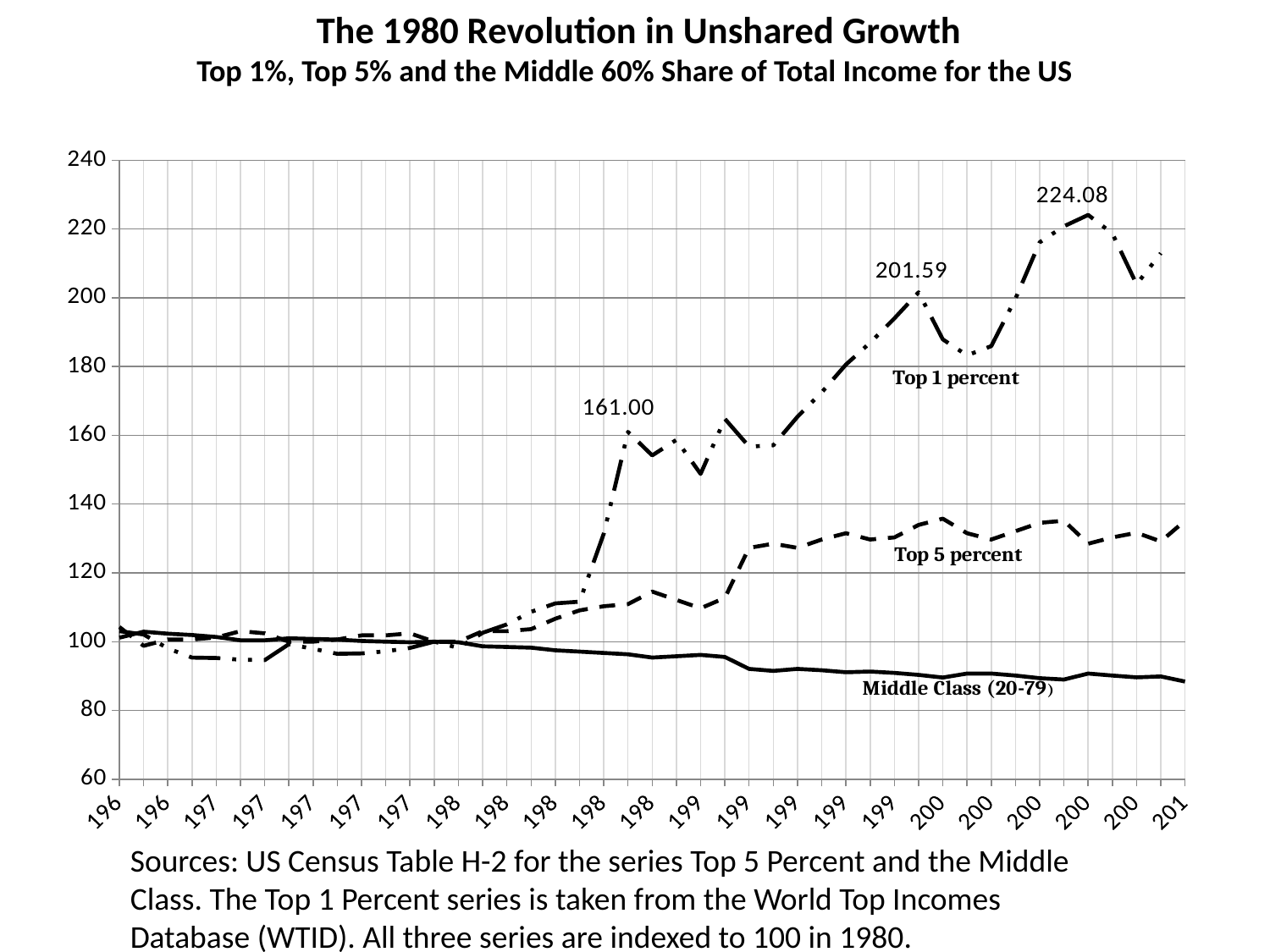
What is the difference between the labeled values 224.08 and 201.59 on the Top 1 percent line? 22.49 What kind of chart is shown on the slide? Line chart What is the highest data label shown on the Top 1 percent line? 224.08 How many data series are plotted on the chart? 3 What is the middle data label printed on the Top 1 percent line, between 161.00 and 224.08? 201.59 Does the Middle Class (20-79) series generally rise or fall from left to right across the chart? Fall What is the difference between the labeled values 224.08 and 161.00 on the Top 1 percent line? 63.08 At the right end of the chart, which series is higher: Top 1 percent or Top 5 percent? Top 1 percent At the right end of the chart, is the value for the Middle Class (20-79) series greater or less than 100? less What is the first (leftmost) data label printed on the Top 1 percent line? 161.00 Which series has the lowest value at the right end of the chart? Middle Class (20-79) Which series on the chart has its values printed as data labels? Top 1 percent